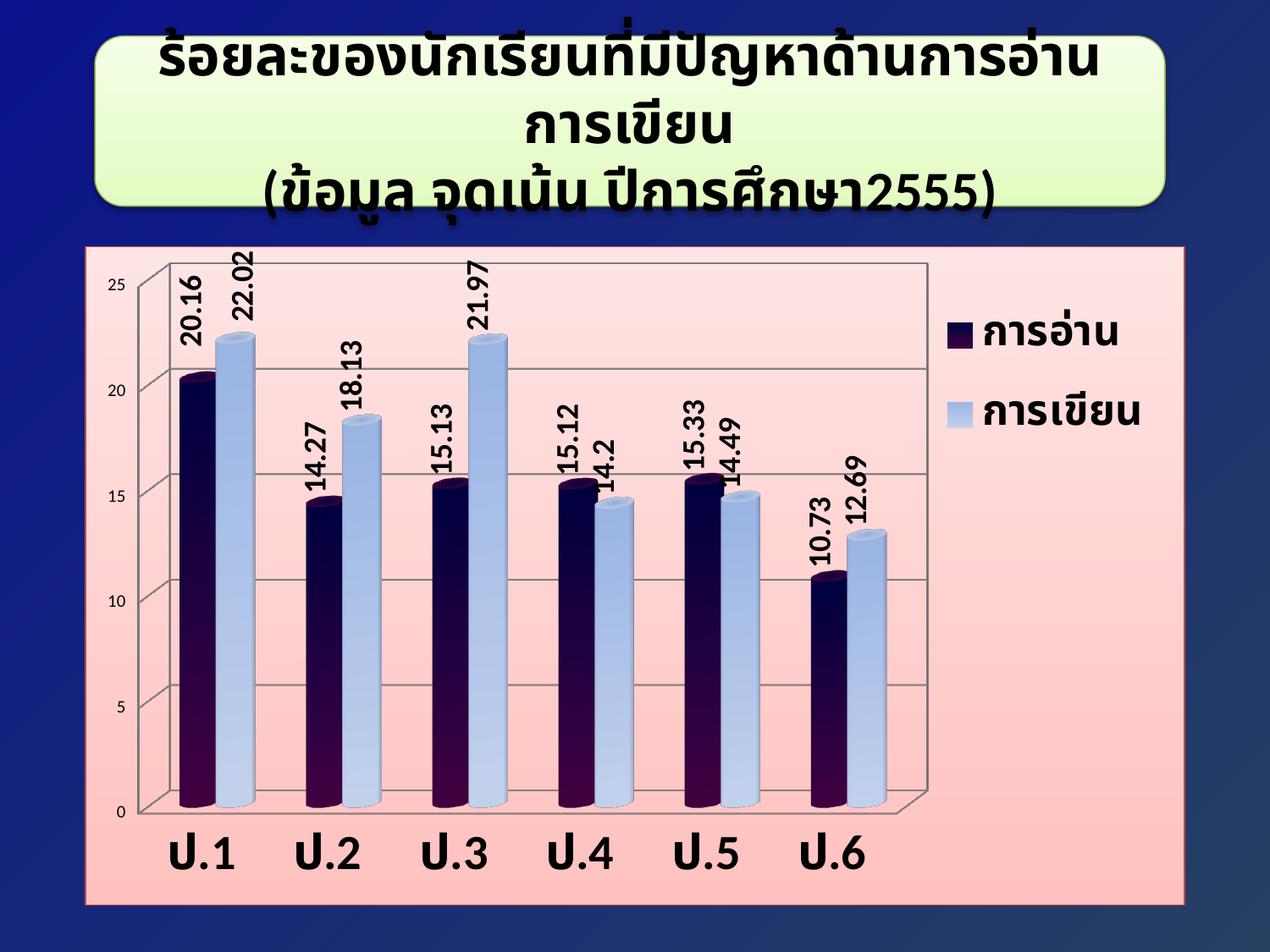
Is the value for การเขียน at ป.1 greater or less than 20? greater What is the value for การเขียน at ป.3? 21.97 What is the value for การอ่าน at ป.5? 15.33 How many series does the legend list? 2 Which category has the lowest value for การอ่าน? ป.6 Which category has the highest value for การเขียน? ป.1 What is the value for การเขียน at ป.6? 12.69 What kind of chart is shown on the slide? bar chart What is the value for การอ่าน at ป.1? 20.16 What is the difference between the การเขียน and การอ่าน values at ป.2? 3.86 At ป.4, which series has the larger value, การอ่าน or การเขียน? การอ่าน How many categories are shown on the x axis? 6